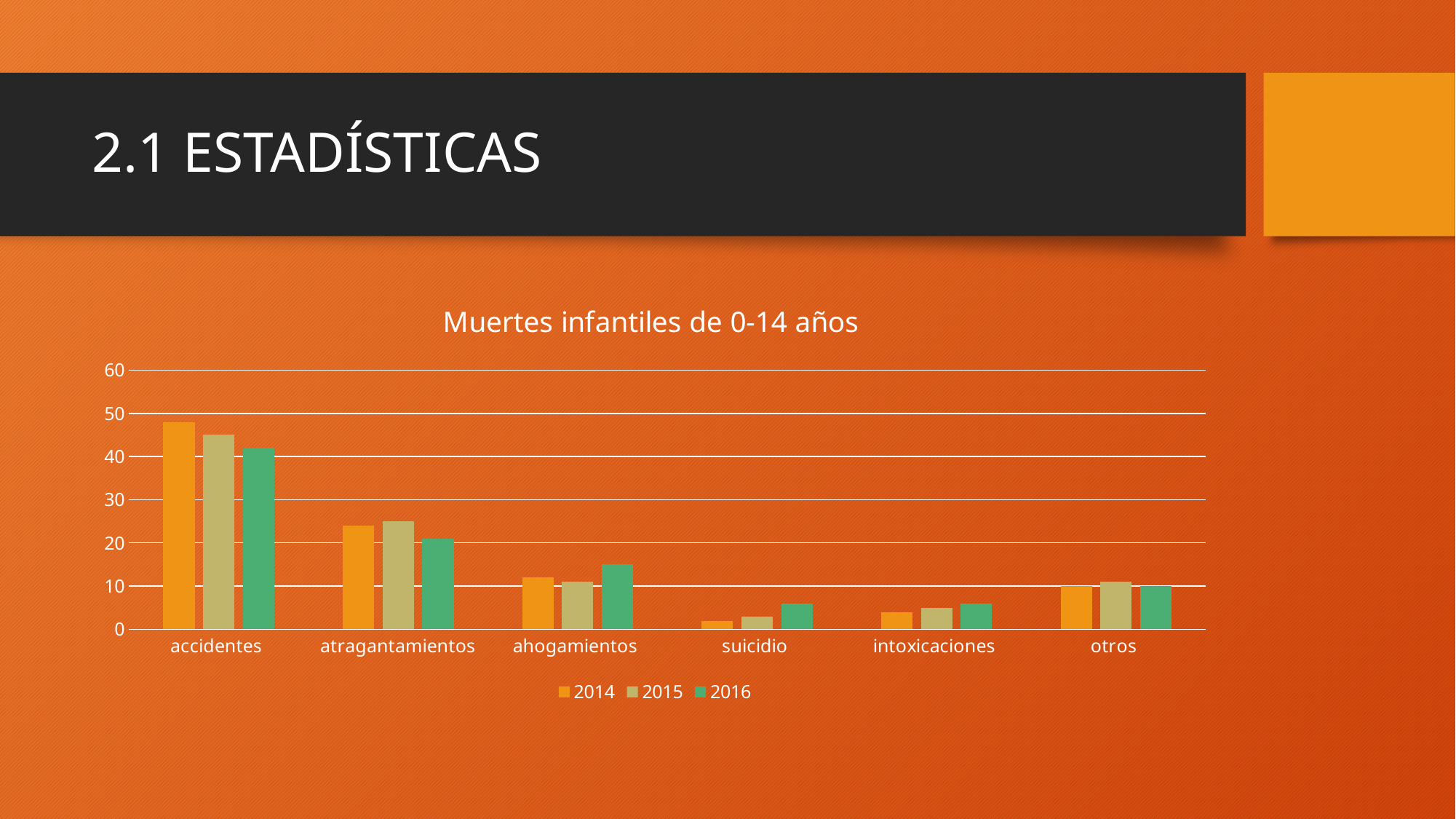
Is the value for accidentes in 2014 greater or less than 40? greater How many series does the legend list? 3 Is the value for atragantamientos in 2015 greater or less than 20? greater How many categories are shown on the x axis? 6 Which years are listed in the legend? 2014, 2015, 2016 For accidentes, which is larger: the 2014 value or the 2016 value? 2014 What type of chart is shown on the slide? bar chart Which category has the lowest value for 2014? suicidio For ahogamientos, which is larger: the 2014 value or the 2016 value? 2016 Is the value for suicidio in 2014 greater or less than 10? less What is the title of the chart? Muertes infantiles de 0-14 años Which category has the highest value for 2014? accidentes